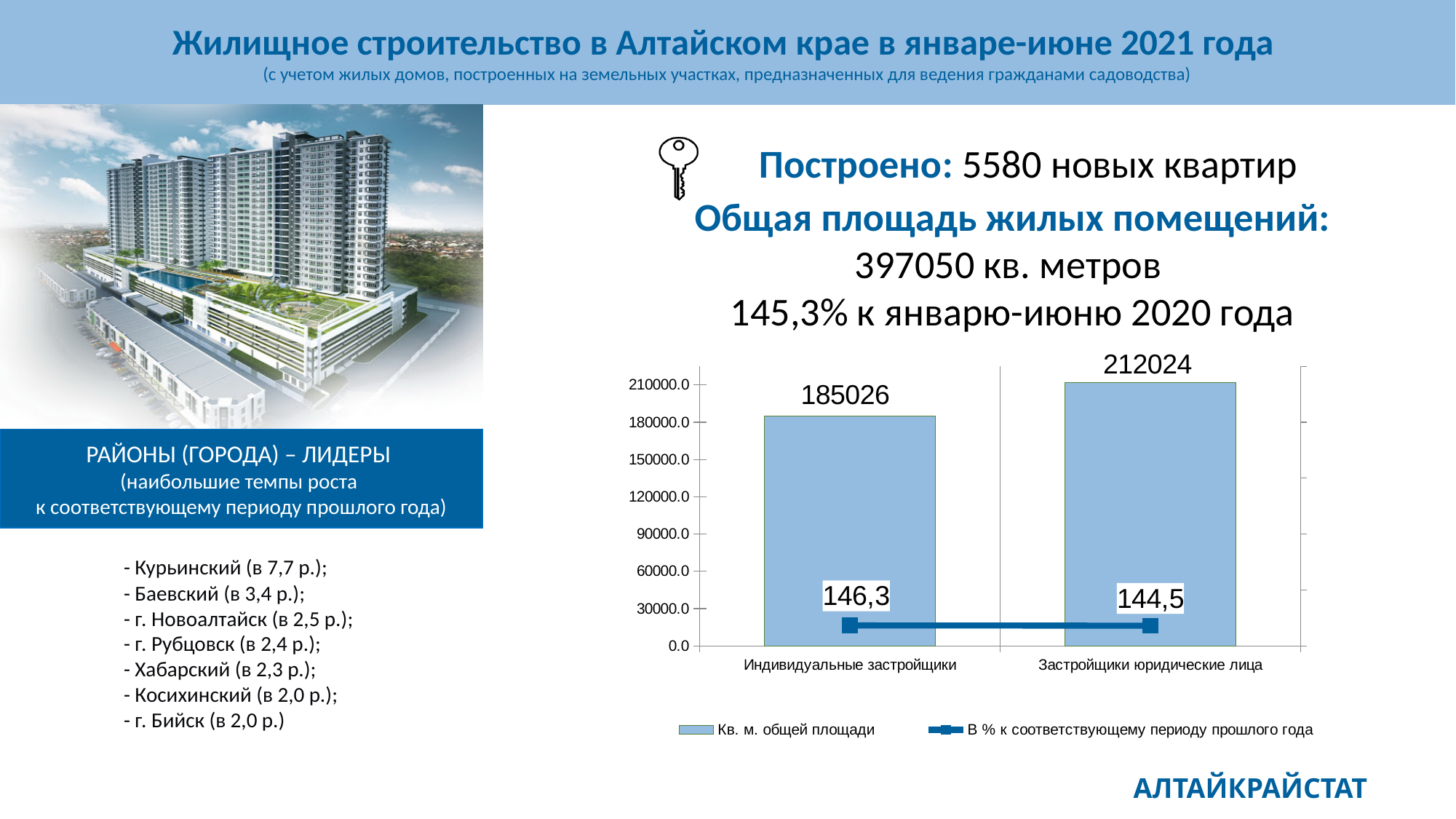
What is the value of 'Кв. м. общей площади' for 'Индивидуальные застройщики'? 185026 What is the value of 'В % к соответствующему периоду прошлого года' for 'Индивидуальные застройщики'? 146,3 Which category has the lower value of 'В % к соответствующему периоду прошлого года'? Застройщики юридические лица How many series does the chart legend list? 2 Which is larger: the 'В % к соответствующему периоду прошлого года' value for 'Индивидуальные застройщики' or for 'Застройщики юридические лица'? Индивидуальные застройщики Which category has the higher value of 'Кв. м. общей площади'? Застройщики юридические лица What is the value of 'В % к соответствующему периоду прошлого года' for 'Застройщики юридические лица'? 144,5 Is the 'Кв. м. общей площади' value for 'Индивидуальные застройщики' greater or less than 180000.0? greater How many categories are shown on the x axis of the chart? 2 What is the value of 'Кв. м. общей площади' for 'Застройщики юридические лица'? 212024 What is the difference in 'Кв. м. общей площади' between 'Застройщики юридические лица' and 'Индивидуальные застройщики'? 26998 What kind of chart is used to show 'Кв. м. общей площади'? bar chart